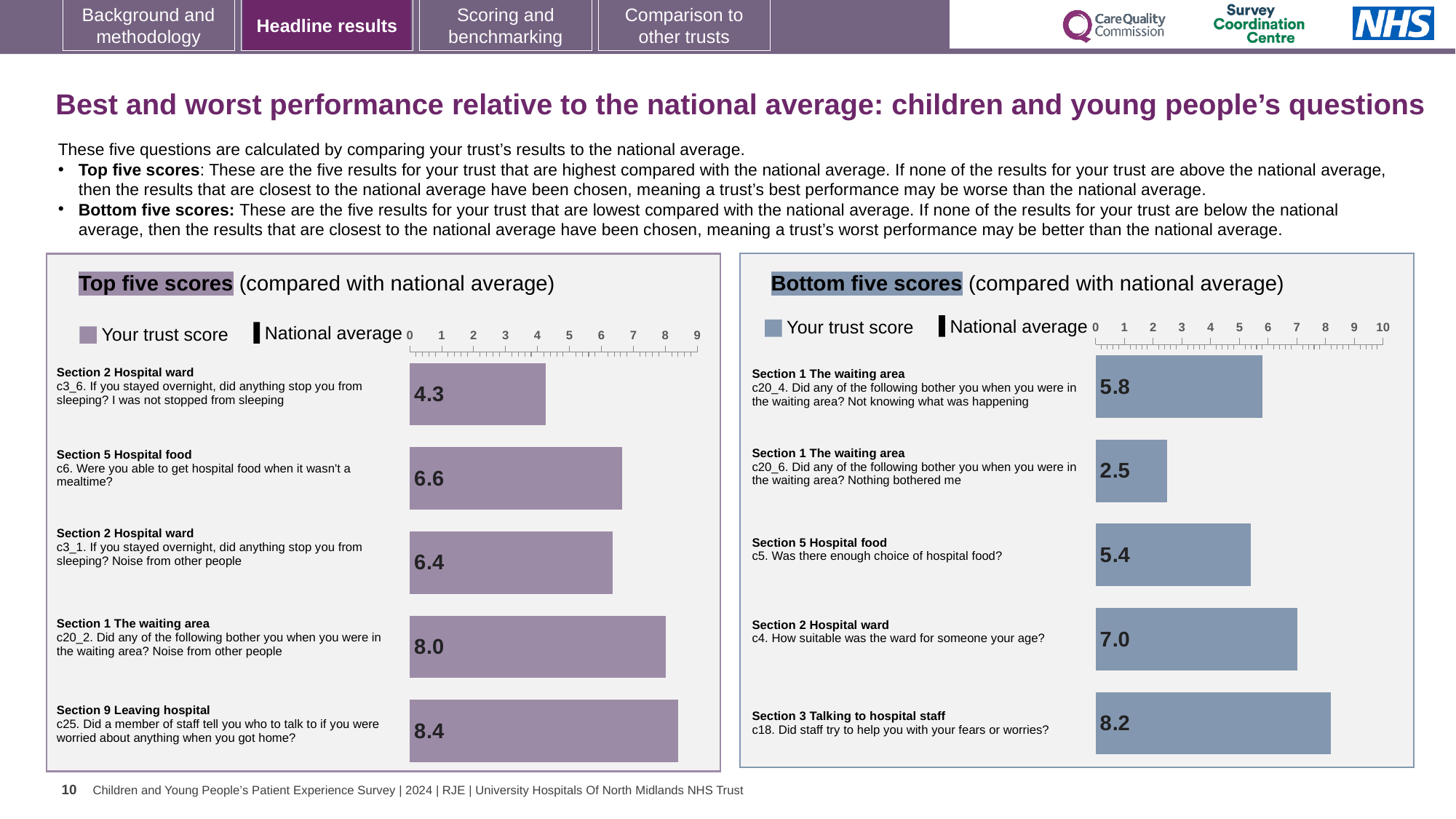
In the Top five scores chart, which question has the highest trust score? c25. Did a member of staff tell you who to talk to if you were worried about anything when you got home? What is the maximum value shown on the axis of the Bottom five scores chart? 10 In the Bottom five scores chart, which question has the lowest trust score? c20_6. Did any of the following bother you when you were in the waiting area? Nothing bothered me In the Bottom five scores chart, what is the trust score for c20_6 (Nothing bothered me)? 2.5 In the Bottom five scores chart, what is the difference between the trust scores for c18 and c20_6? 5.7 How many questions are shown in the Bottom five scores chart? 5 In the Bottom five scores chart, what is the trust score for c4 (How suitable was the ward for someone your age)? 7.0 In the Top five scores chart, what is the trust score for c3_6 (I was not stopped from sleeping)? 4.3 What type of chart is the Top five scores chart? Bar chart In the Bottom five scores chart, which has the larger trust score: c20_4 or c5? c20_4 In the Top five scores chart, what is the difference between the trust scores for c6 and c3_1? 0.2 In the Top five scores chart, what is the trust score for c25 (Did a member of staff tell you who to talk to if you were worried about anything when you got home)? 8.4